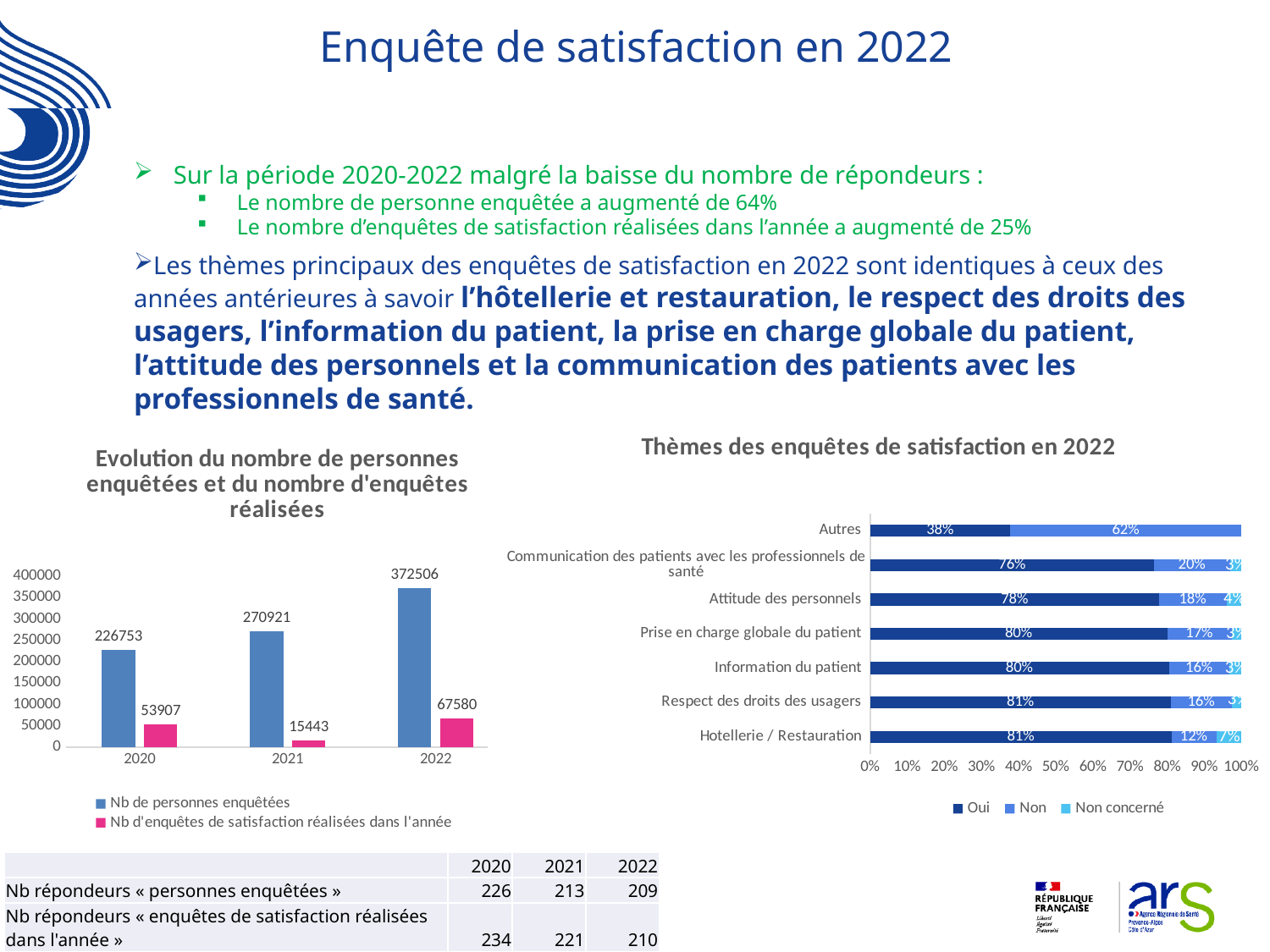
In the chart 'Evolution du nombre de personnes enquêtées et du nombre d'enquêtes réalisées', which year has the lowest number of 'Nb d'enquêtes de satisfaction réalisées dans l'année'? 2021 In the chart 'Evolution du nombre de personnes enquêtées et du nombre d'enquêtes réalisées', what is the number of 'Nb de personnes enquêtées' in 2022? 372506 In the chart 'Thèmes des enquêtes de satisfaction en 2022', what is the 'Oui' percentage for 'Attitude des personnels'? 78% In the chart 'Evolution du nombre de personnes enquêtées et du nombre d'enquêtes réalisées', does 'Nb de personnes enquêtées' rise or fall from 2020 to 2022? rise In the chart 'Evolution du nombre de personnes enquêtées et du nombre d'enquêtes réalisées', what is the value of 'Nb d'enquêtes de satisfaction réalisées dans l'année' in 2021? 15443 In the chart 'Thèmes des enquêtes de satisfaction en 2022', what is the 'Non' percentage for 'Autres'? 62% How many themes are shown in the chart 'Thèmes des enquêtes de satisfaction en 2022'? 7 In the chart 'Thèmes des enquêtes de satisfaction en 2022', which theme has the lowest 'Oui' percentage? Autres In the chart 'Thèmes des enquêtes de satisfaction en 2022', which is larger: the 'Non' percentage for 'Communication des patients avec les professionnels de santé' or for 'Hotellerie / Restauration'? Communication des patients avec les professionnels de santé What kind of chart is 'Thèmes des enquêtes de satisfaction en 2022'? stacked bar chart How many series does the legend of the chart 'Evolution du nombre de personnes enquêtées et du nombre d'enquêtes réalisées' list? 2 In the chart 'Evolution du nombre de personnes enquêtées et du nombre d'enquêtes réalisées', what is the difference between 'Nb de personnes enquêtées' in 2022 and in 2020? 145753